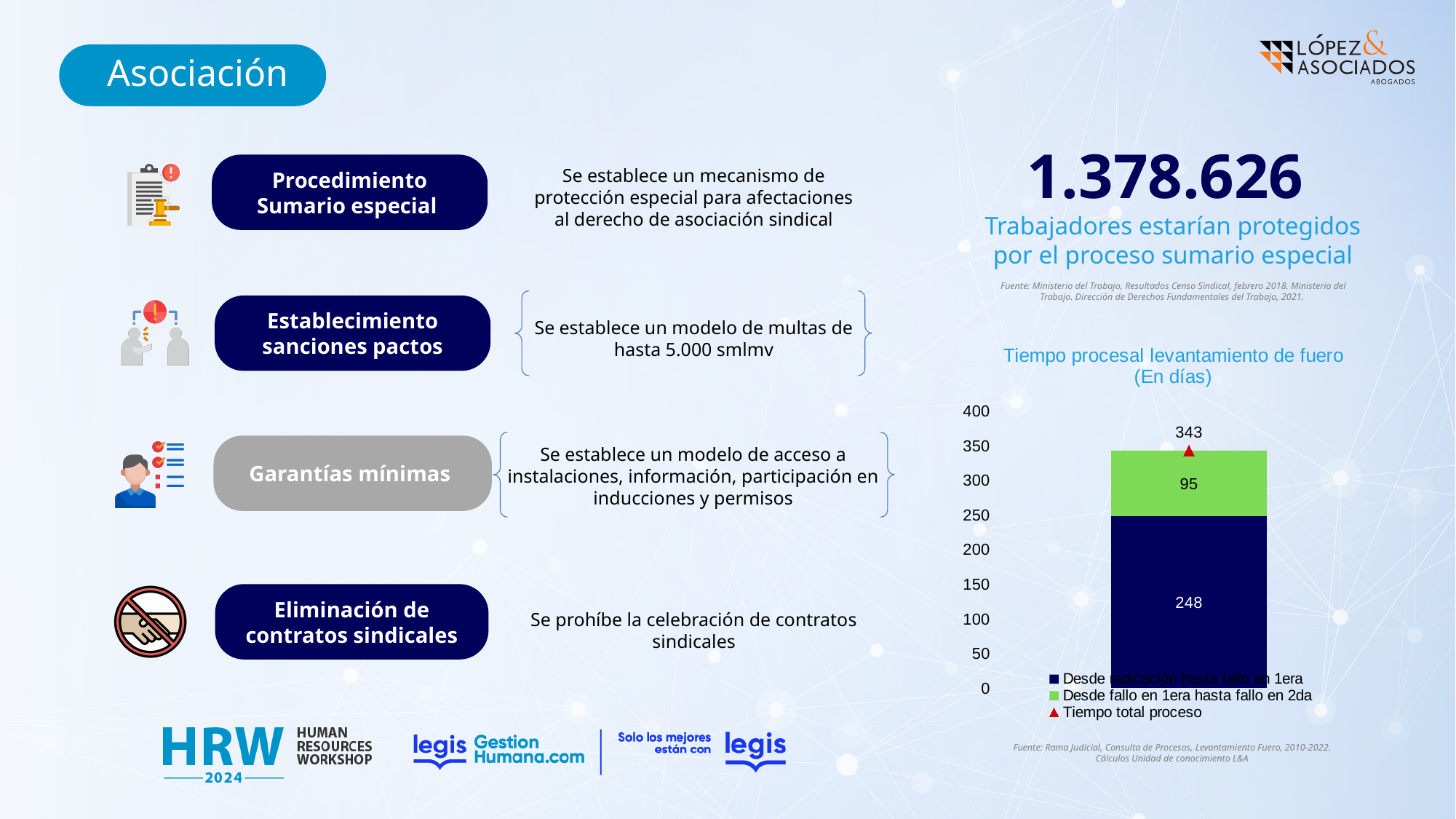
How many entries does the legend of the chart "Tiempo procesal levantamiento de fuero" list? 3 In the chart "Tiempo procesal levantamiento de fuero", which series has the smallest value? Desde fallo en 1era hasta fallo en 2da In the chart "Tiempo procesal levantamiento de fuero", what value is shown for "Tiempo total proceso"? 343 What type of chart is shown under the title "Tiempo procesal levantamiento de fuero"? bar chart In the chart "Tiempo procesal levantamiento de fuero", is the value for "Desde radicación hasta fallo en 1era" greater or less than 200? greater In the chart "Tiempo procesal levantamiento de fuero", what colour is the "Desde fallo en 1era hasta fallo en 2da" segment? green What is the title of the chart on the slide? Tiempo procesal levantamiento de fuero (En días) In the chart "Tiempo procesal levantamiento de fuero", which segment is larger: "Desde radicación hasta fallo en 1era" or "Desde fallo en 1era hasta fallo en 2da"? Desde radicación hasta fallo en 1era In the chart "Tiempo procesal levantamiento de fuero", what is the value for "Desde fallo en 1era hasta fallo en 2da"? 95 In the chart "Tiempo procesal levantamiento de fuero", what is the value for "Desde radicación hasta fallo en 1era"? 248 In the chart "Tiempo procesal levantamiento de fuero", what is the total of the stacked bar? 343 In the chart "Tiempo procesal levantamiento de fuero", what is the difference between the "Desde radicación hasta fallo en 1era" segment and the "Desde fallo en 1era hasta fallo en 2da" segment? 153